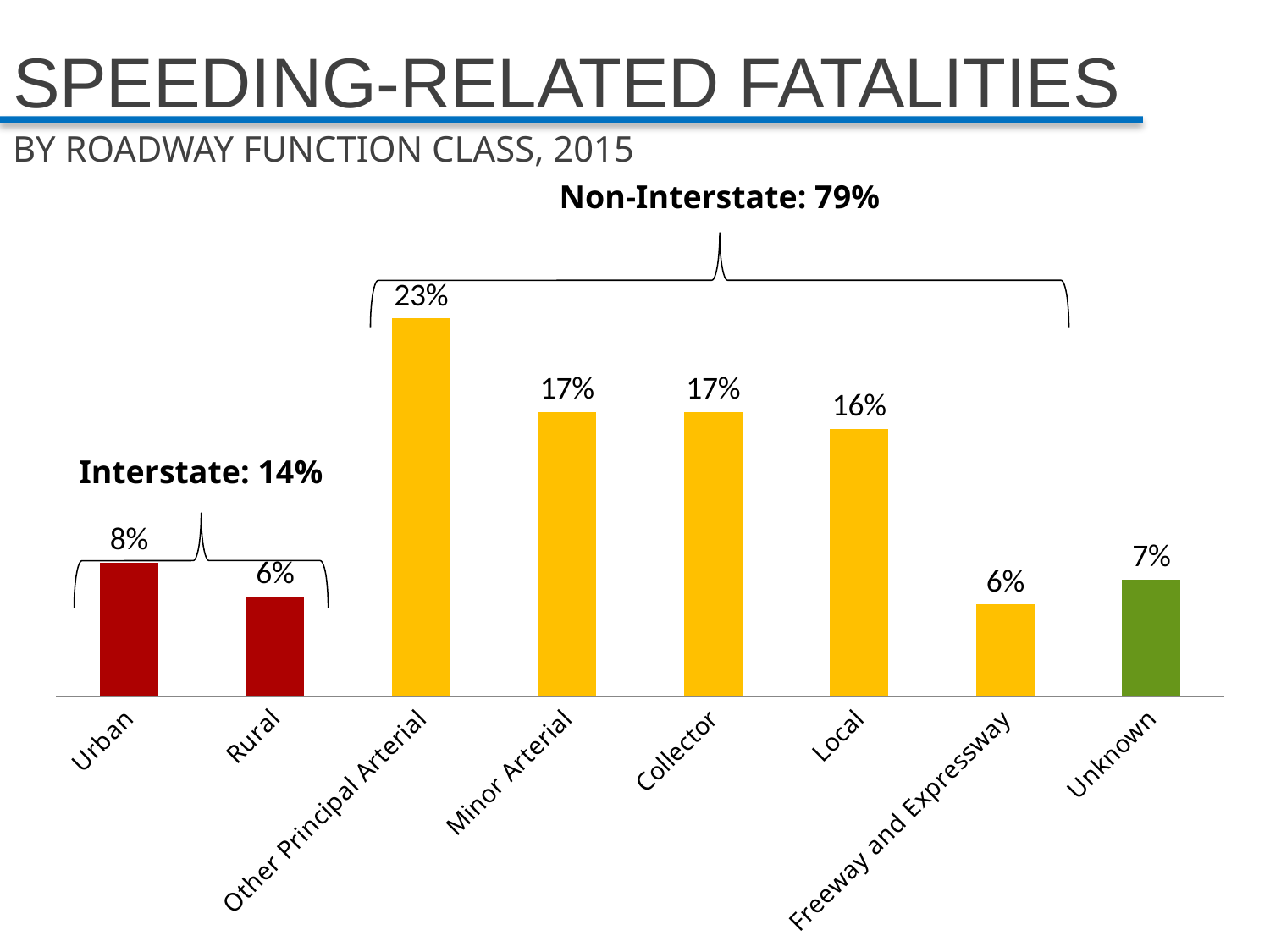
How many roadway function class categories are shown on the x axis? 8 What is the difference between the values for Urban and Rural? 2% What is the value shown for Urban? 8% What total percentage is labelled for the Interstate group? 14% What kind of chart is shown on the slide? Bar chart What is the value shown for Local? 16% What is the difference between the values for Other Principal Arterial and Local? 7% Which roadway function class has the highest share of speeding-related fatalities? Other Principal Arterial What total percentage is labelled for the Non-Interstate group? 79% What percentage of speeding-related fatalities occurred on Other Principal Arterial roads? 23% Which is larger, the value for Local or the value for Minor Arterial? Minor Arterial What is the value shown for Unknown? 7%